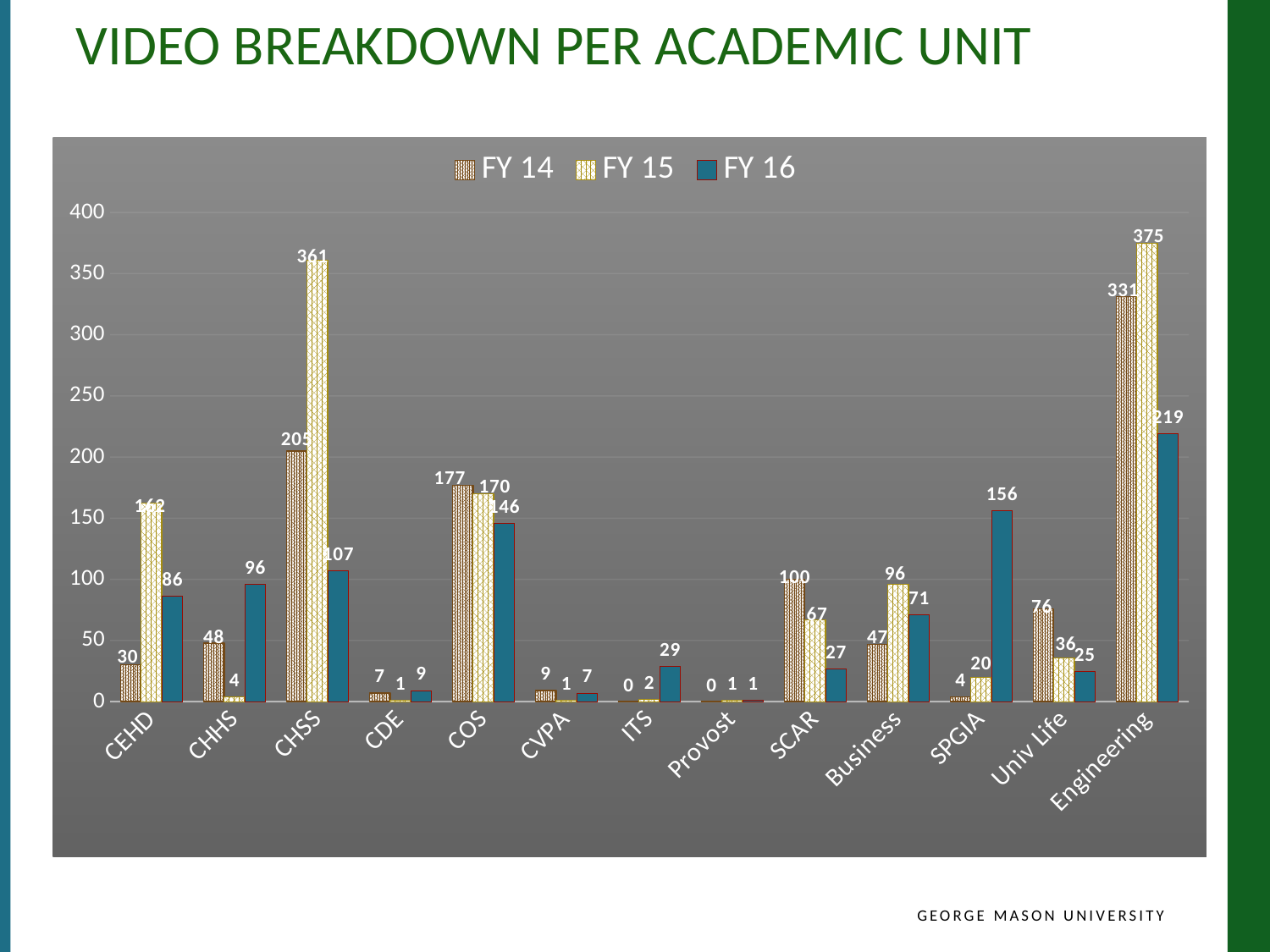
What is the FY 16 value for SPGIA? 156 Is the FY 15 value for CEHD greater or less than 100? greater What is the difference between the FY 15 and FY 16 values for Engineering? 156 For COS, which is larger: the FY 14 value or the FY 15 value? FY 14 What kind of chart is shown on the slide? bar chart How many academic units are shown on the x axis? 13 Which academic unit has the lowest FY 16 value? Provost What is the FY 16 value for ITS? 29 Which academic unit has the highest FY 15 value? Engineering How many series does the legend list? 3 What is the title of the chart? VIDEO BREAKDOWN PER ACADEMIC UNIT What is the FY 15 value for CHSS? 361